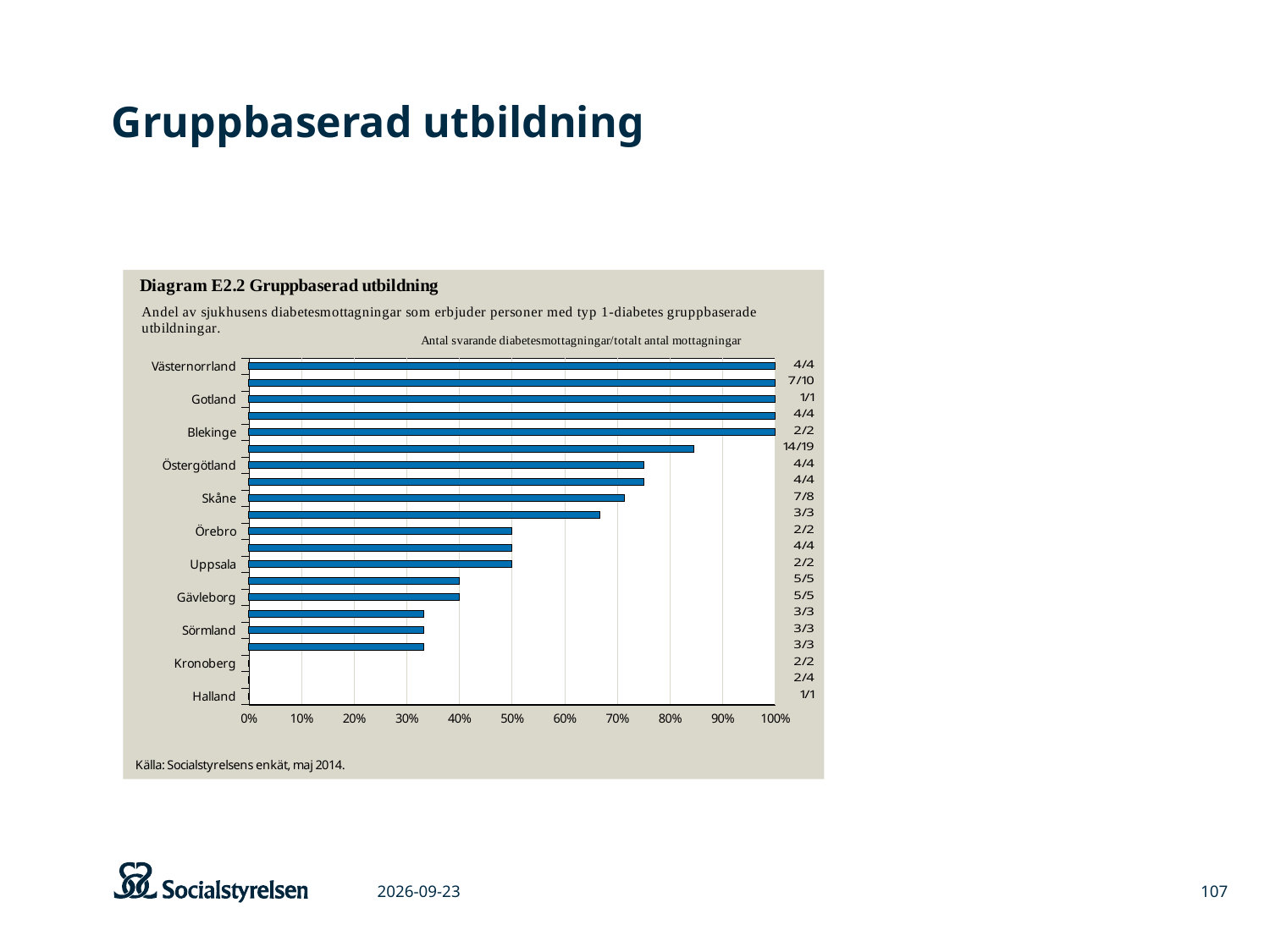
What is the value for Örebro? 50% What is the value for Halland? 0% Do the bar values rise or fall going from the top of the chart to the bottom? fall Is the value for Sörmland greater or less than 40%? less What is the value for Gävleborg? 40% Which has the larger value, Gävleborg or Sörmland? Gävleborg What is the title of the diagram shown on the slide? Diagram E2.2 Gruppbaserad utbildning What kind of chart is shown on the slide? bar chart Is the value for Östergötland greater or less than 70%? greater What is the value for Västernorrland? 100% What fraction (antal svarande/totalt antal mottagningar) is printed next to the Skåne bar? 7/8 What fraction is printed next to the Gävleborg bar? 5/5